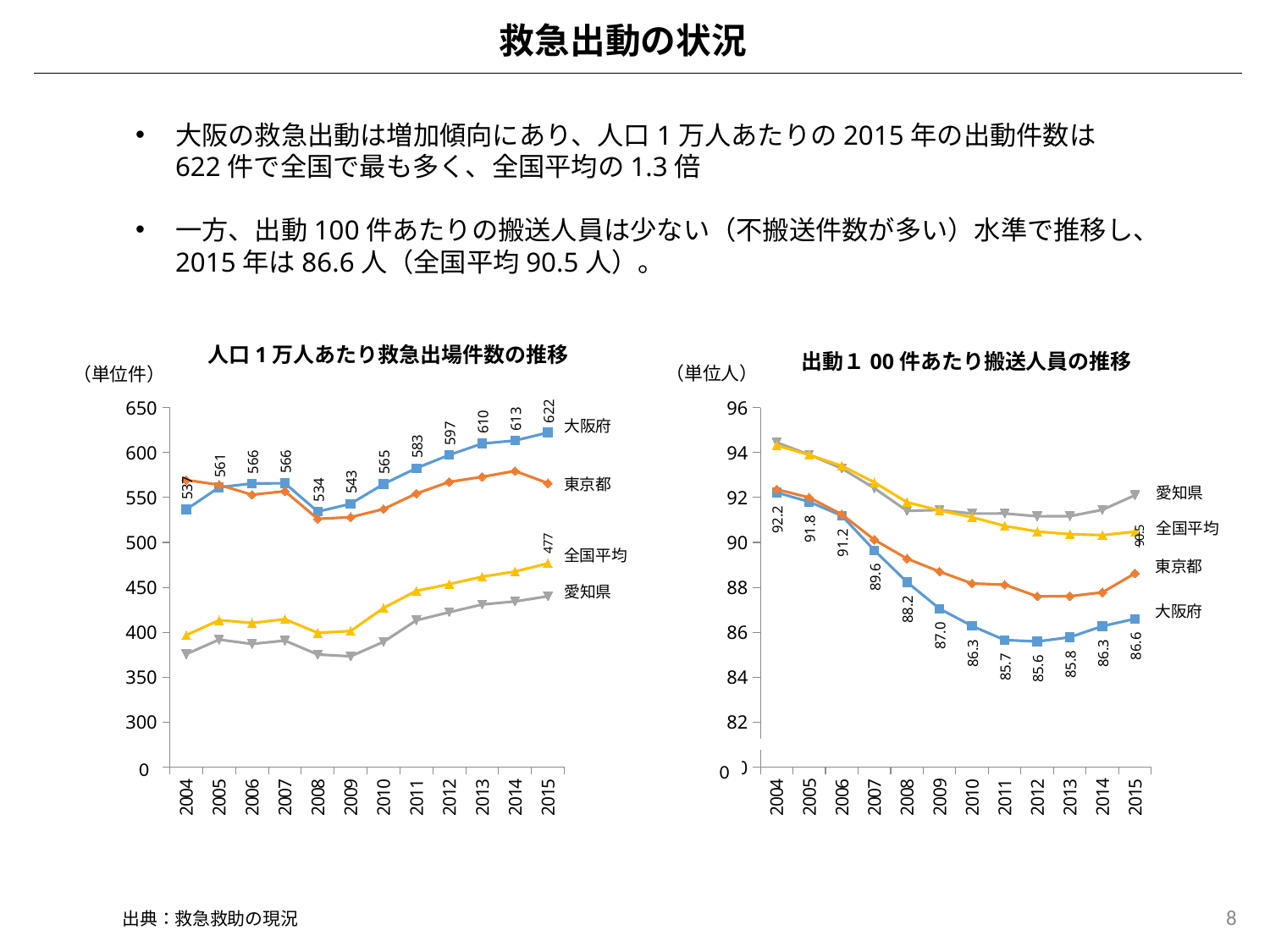
How many series are plotted in the left chart (人口1万人あたり救急出場件数の推移)? 4 In the left chart (人口1万人あたり救急出場件数の推移), which is higher in 2015, 大阪府 or 東京都? 大阪府 In the left chart (人口1万人あたり救急出場件数の推移), what is the value for 大阪府 in 2015? 622 In the left chart (人口1万人あたり救急出場件数の推移), what is the value for 全国平均 in 2015? 477 In the left chart (人口1万人あたり救急出場件数の推移), what is the value for 大阪府 in 2008? 534 In the right chart (出動100件あたり搬送人員の推移), is the value for 愛知県 in 2004 greater or less than 94? greater In the right chart (出動100件あたり搬送人員の推移), what is the difference between the 大阪府 values in 2004 and 2015? 5.6 In the right chart (出動100件あたり搬送人員の推移), what is the value for 大阪府 in 2012? 85.6 How many years are shown on the x axis of the right chart (出動100件あたり搬送人員の推移)? 12 What kind of chart is the left chart (人口1万人あたり救急出場件数の推移)? line chart In the right chart (出動100件あたり搬送人員の推移), in which year is the 大阪府 value lowest? 2012 In the left chart (人口1万人あたり救急出場件数の推移), by how much did the 大阪府 value increase from 2004 to 2015? 85